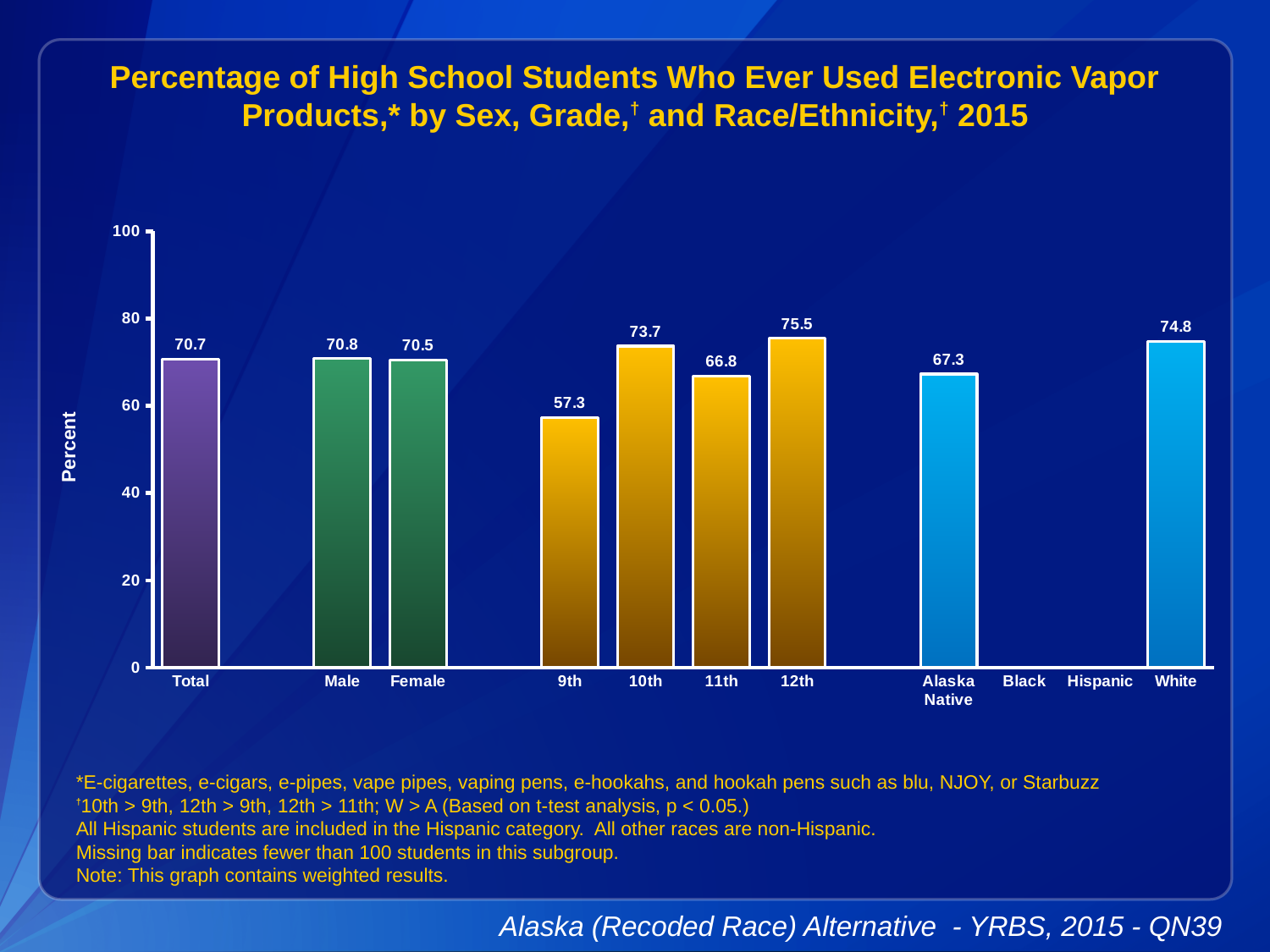
What is the value for Total? 70.7 What kind of chart is shown on the slide? bar chart What is the label on the vertical axis? Percent What is the value for Alaska Native? 67.3 What is the value for 9th grade? 57.3 Which category has the lowest value among the bars shown? 9th How many categories have a bar plotted on the chart? 9 Which categories have no bar shown? Black and Hispanic Which is larger, the value for 10th grade or the value for 11th grade? 10th Which category has the highest value? 12th What is the difference between the values for 12th and 9th grade? 18.2 Is the value for White greater or less than 60? greater